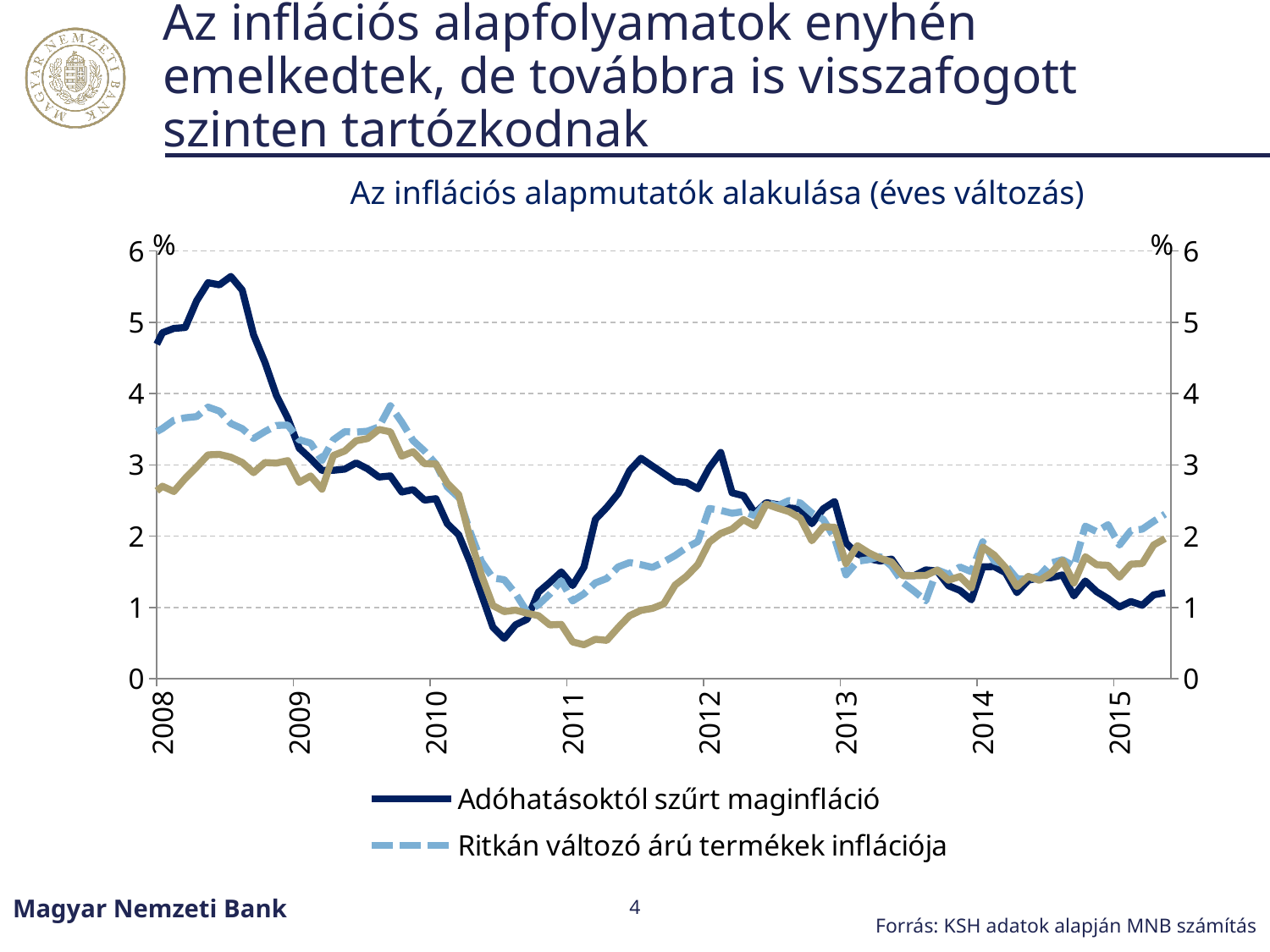
Is the value of Adóhatásoktól szűrt maginfláció at the start of 2008 greater or less than 4? greater At the start of 2008, which series is higher: Adóhatásoktól szűrt maginfláció or Ritkán változó árú termékek inflációja? Adóhatásoktól szűrt maginfláció Is the value of Ritkán változó árú termékek inflációja at the start of 2008 greater or less than 3? greater At the end of 2015, which series is higher: Adóhatásoktól szűrt maginfláció or Ritkán változó árú termékek inflációja? Ritkán változó árú termékek inflációja How many series does the chart legend list? 2 Does Adóhatásoktól szűrt maginfláció overall rise or fall from 2008 to 2015? fall What is the title of the chart? Az inflációs alapmutatók alakulása (éves változás) Is the peak value of Adóhatásoktól szűrt maginfláció in 2008 greater or less than 5? greater What kind of chart is shown on the slide? line chart What unit is shown on the vertical axis of the chart? %